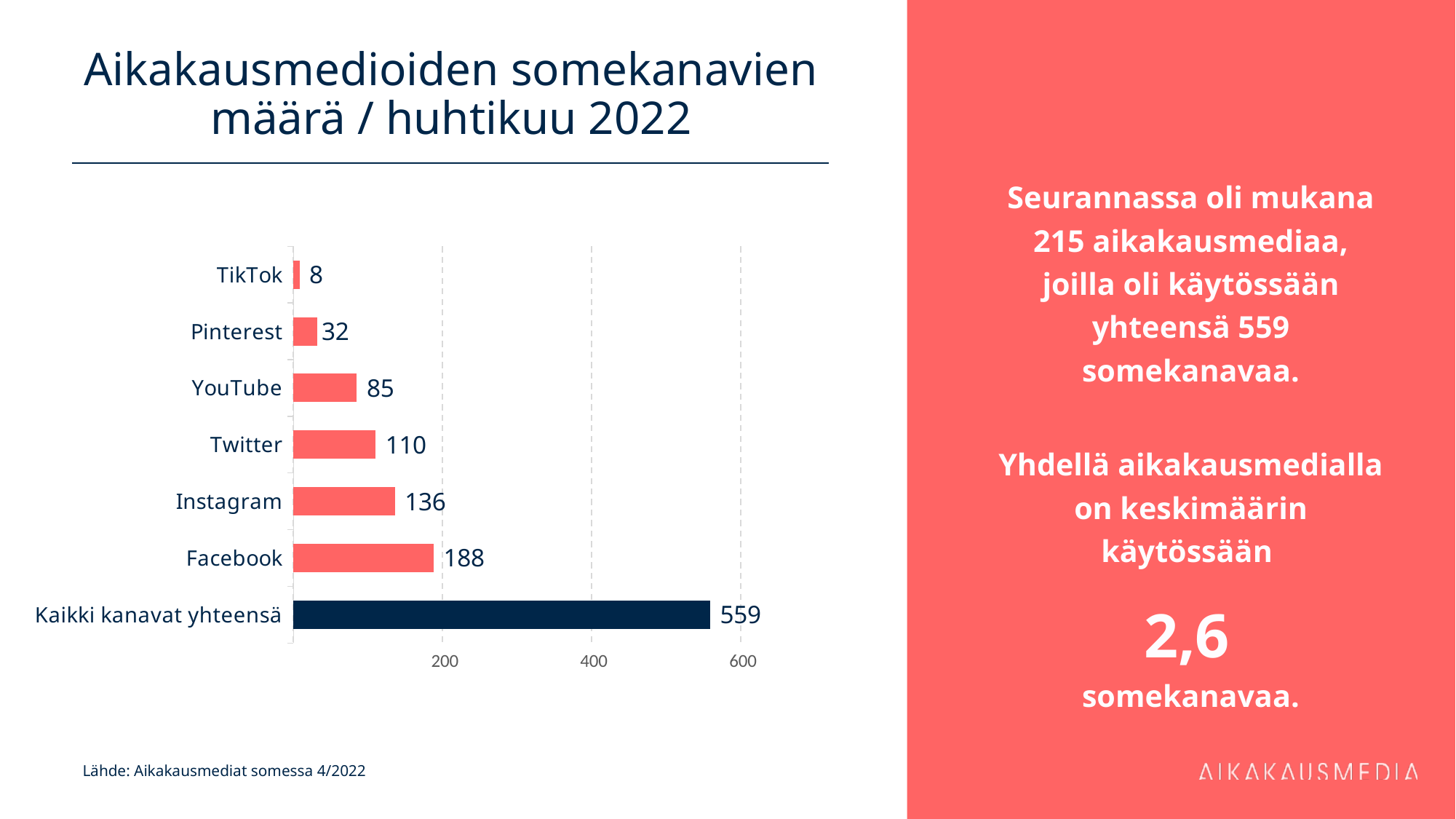
How many categories are shown in the chart? 7 What is the value for TikTok? 8 What is the title of the chart? Aikakausmedioiden somekanavien määrä / huhtikuu 2022 What is the value for Kaikki kanavat yhteensä? 559 Which has a larger value, Twitter or YouTube? Twitter Is the value for Facebook greater or less than 200? less Which individual social media channel has the highest value? Facebook What is the value for Instagram? 136 Which category has the lowest value? TikTok What is the difference between the values for Facebook and Instagram? 52 What is the value for Facebook? 188 What kind of chart is shown on the slide? bar chart